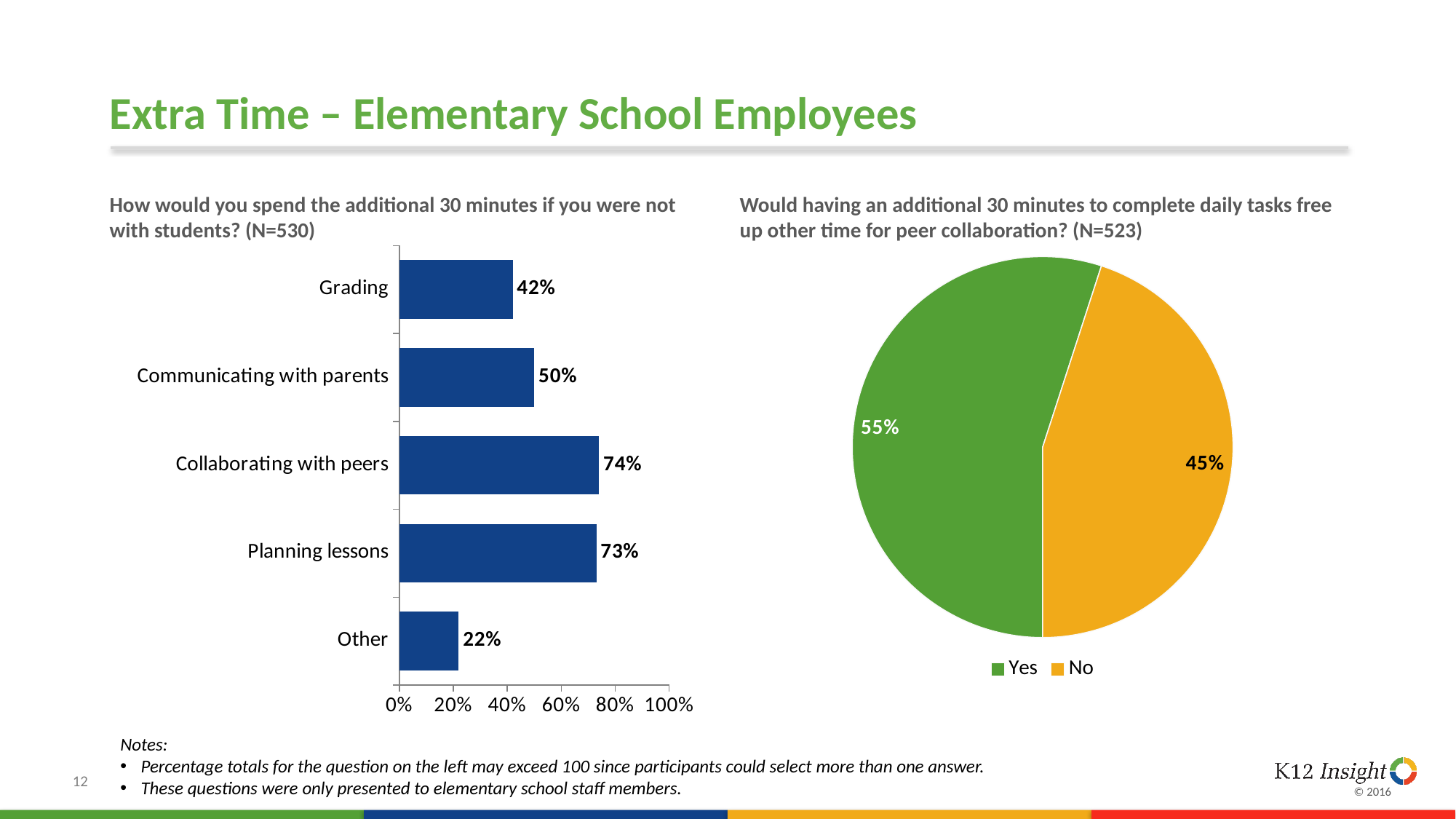
How many entries does the legend of the pie chart on the right list? 2 In the bar chart on the left, what is the difference between Collaborating with peers and Grading? 32% In the pie chart on the right, what is the value for No? 45% In the bar chart on the left, which is larger: Communicating with parents or Other? Communicating with parents In the bar chart on the left, what percentage of respondents chose Grading? 42% In the pie chart on the right, what share of respondents answered Yes? 55% How many categories are shown in the bar chart on the left? 5 In the bar chart on the left, what is the value for Communicating with parents? 50% In the bar chart on the left, which category has the highest value? Collaborating with peers In the bar chart on the left, which category has the lowest value? Other What kind of chart is on the left side of the slide? Bar chart In the pie chart on the right, what colour is the Yes slice? Green